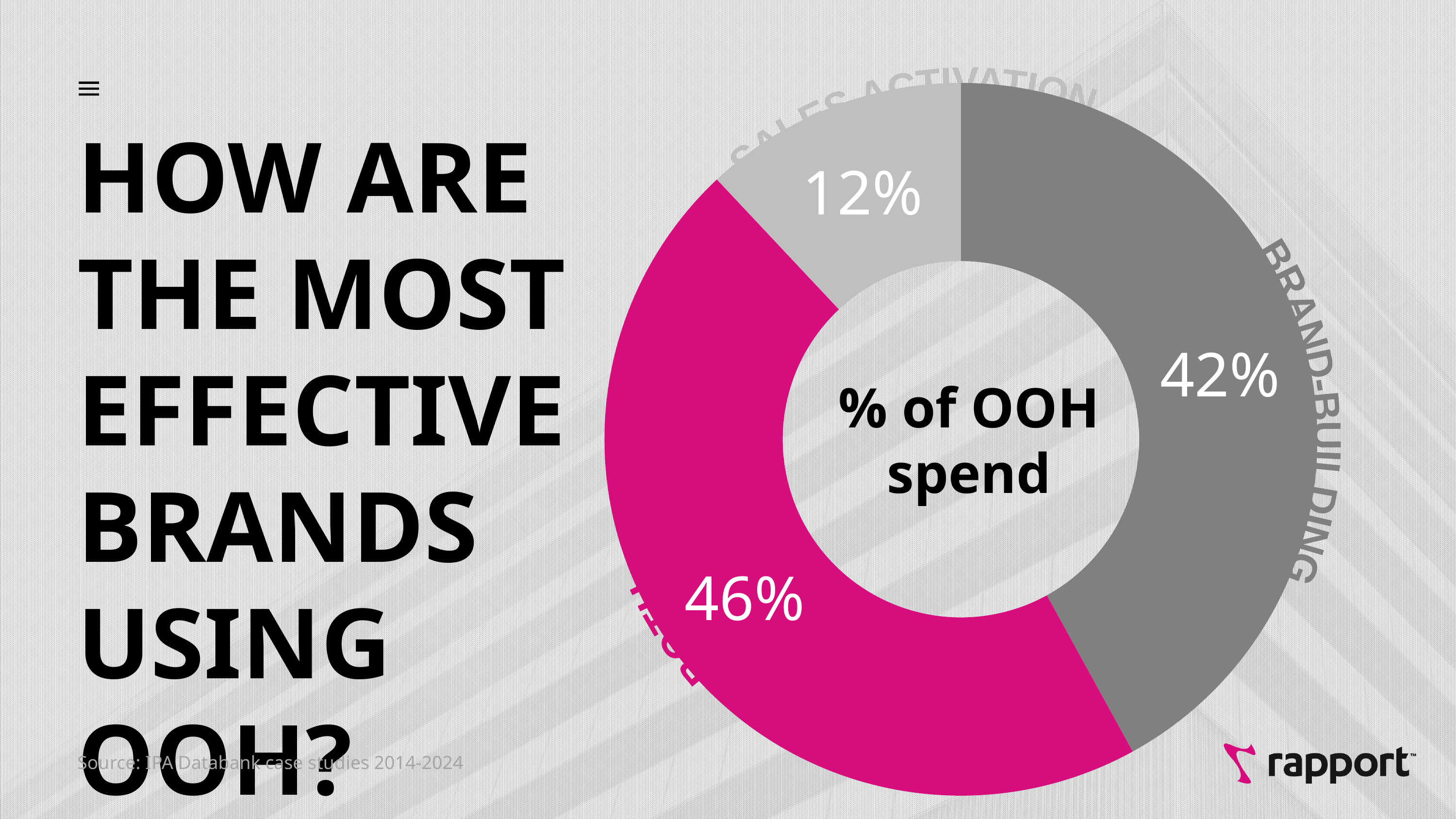
What percentage of OOH spend is shown for Brand-Building? 42% What kind of chart is shown on the slide? Donut chart Which is larger, the Brand-Building share or the Sales Activation share? Brand-Building What colour is the Brand-Building slice of the donut chart? Dark grey Which slice of the donut chart has the smallest share? Sales Activation What text is shown in the centre of the donut chart? % of OOH spend What is the largest value shown on the donut chart? 46% What percentage of OOH spend is shown for Sales Activation? 12% What value is shown on the magenta slice of the donut chart? 46% What is the difference between the magenta slice's value and the Brand-Building value? 4 percentage points How many slices does the donut chart have? 3 What is the difference between the Brand-Building share and the Sales Activation share? 30 percentage points